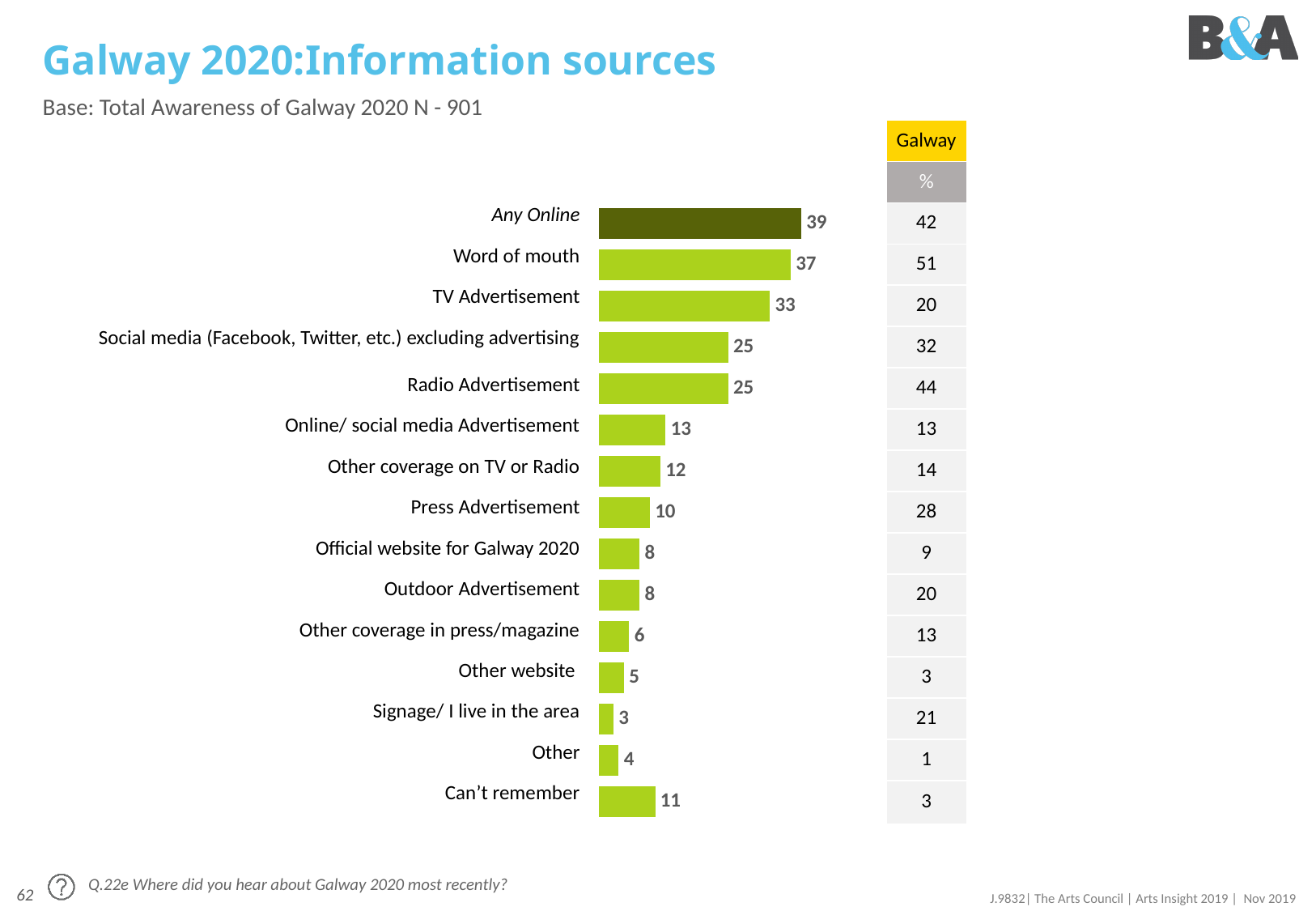
Which category has the highest value in the chart? Any Online What is the difference between the values for Any Online and Word of mouth? 2 What is the title of the slide? Galway 2020:Information sources What is the difference between the values for TV Advertisement and Radio Advertisement? 8 Which is larger, the value for Other coverage on TV or Radio or the value for Press Advertisement? Other coverage on TV or Radio What value is shown for Press Advertisement? 10 What value is shown for Word of mouth? 37 Which category has the lowest value in the chart? Signage/ I live in the area What value is shown for Can't remember? 11 How many categories are shown in the bar chart? 15 What value is shown for TV Advertisement? 33 What kind of chart is shown on the slide? Bar chart